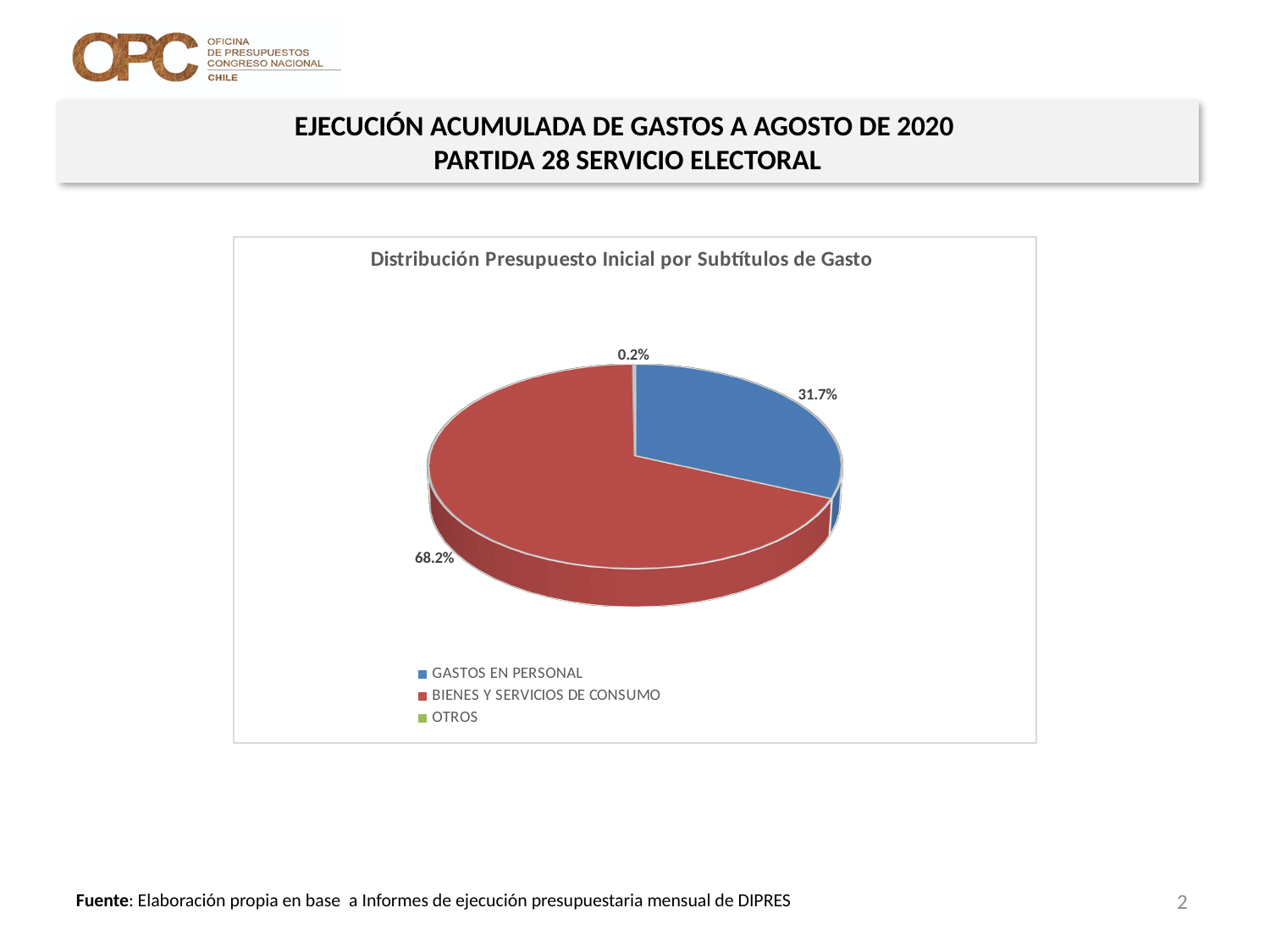
What colour is the slice for GASTOS EN PERSONAL? blue What share of the pie does OTROS represent? 0.2% How many categories does the legend list? 3 What is the difference in percentage points between the BIENES Y SERVICIOS DE CONSUMO share and the GASTOS EN PERSONAL share? 36.5 percentage points What share of the pie does GASTOS EN PERSONAL represent? 31.7% What is the title of the chart? Distribución Presupuesto Inicial por Subtítulos de Gasto Which category has the smallest slice of the pie? OTROS Which category has the largest slice of the pie? BIENES Y SERVICIOS DE CONSUMO Which is larger, the share for GASTOS EN PERSONAL or the share for BIENES Y SERVICIOS DE CONSUMO? BIENES Y SERVICIOS DE CONSUMO What share of the pie does BIENES Y SERVICIOS DE CONSUMO represent? 68.2% What kind of chart is shown on the slide? pie chart